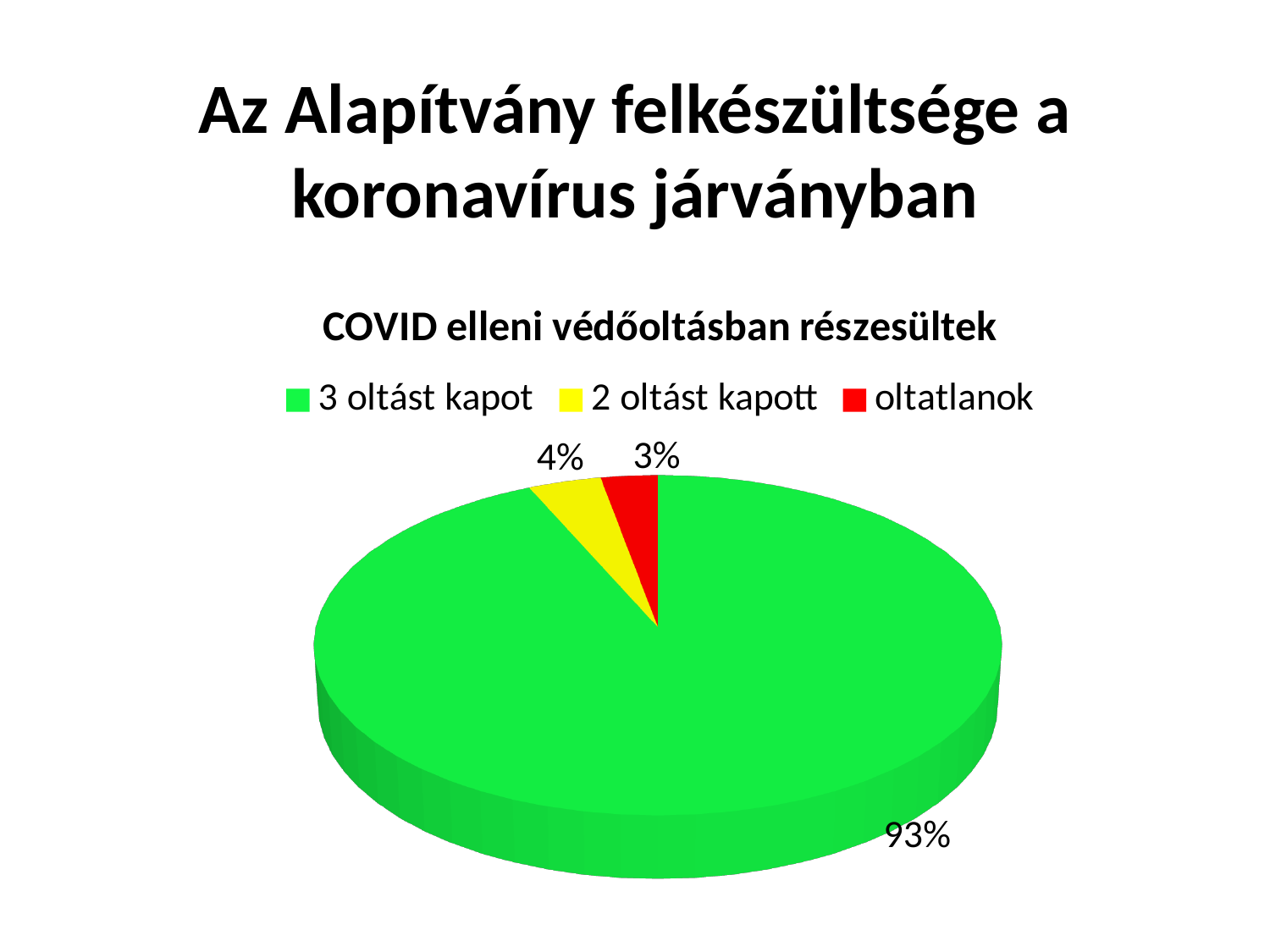
What is the difference in percentage points between '3 oltást kapot' and '2 oltást kapott'? 89 What colour is the slice for 'oltatlanok'? red How many categories does the legend list? 3 What share of the pie is labelled for 'oltatlanok'? 3% What is the chart's title? COVID elleni védőoltásban részesültek Which is larger, the slice for '2 oltást kapott' or the slice for 'oltatlanok'? 2 oltást kapott Which category has the smallest slice? oltatlanok What share of the pie is labelled for '2 oltást kapott'? 4% What share of the pie is labelled for '3 oltást kapot'? 93% How many slices does the pie have? 3 Which category has the largest slice? 3 oltást kapot What kind of chart is shown on the slide? pie chart